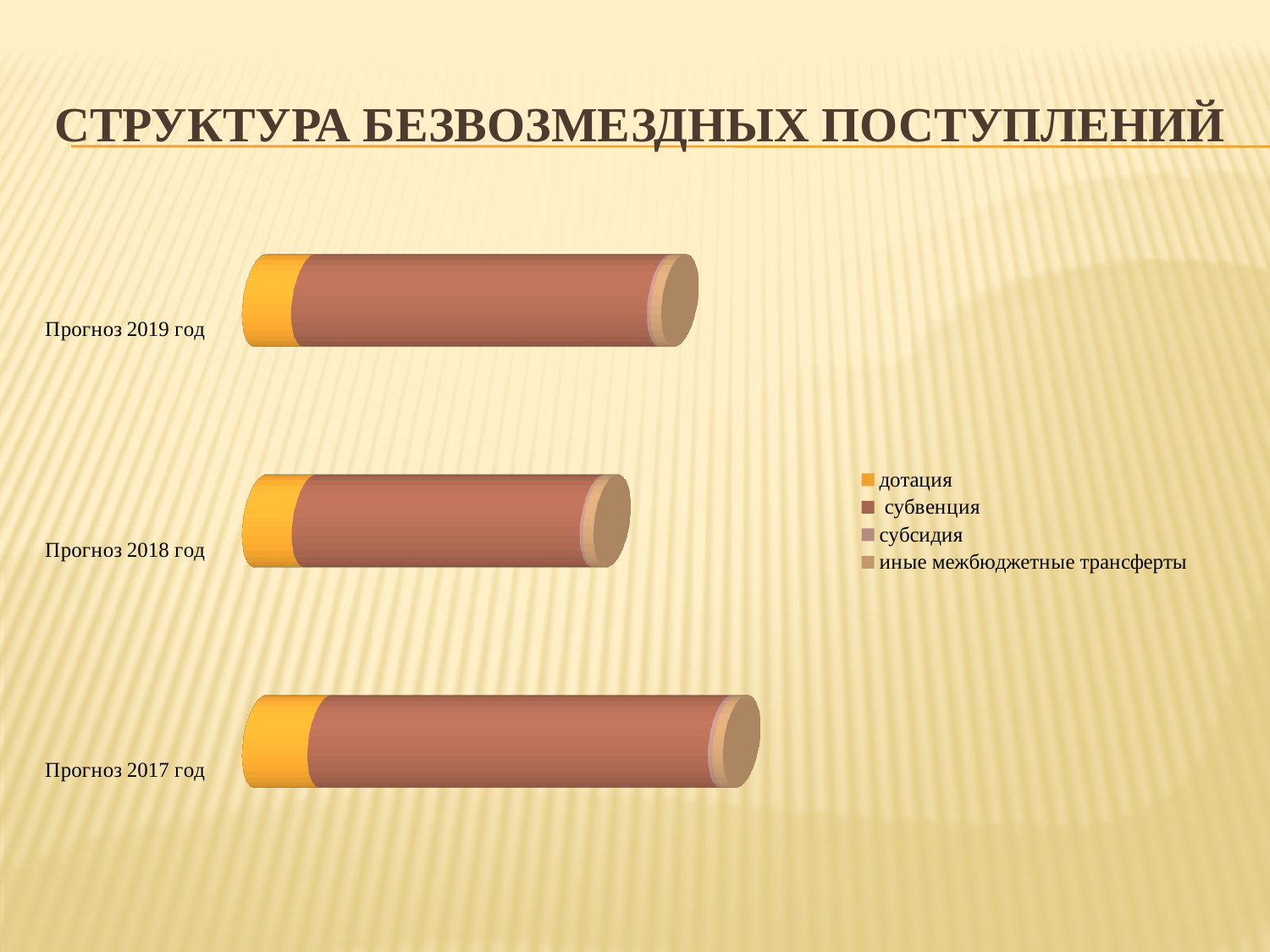
Which series is shown in yellow/orange in the legend? дотация Which category has the longest bar overall? Прогноз 2017 год How many series does the legend list? 4 Which series takes up the largest segment of the Прогноз 2019 год bar? субвенция Are the bars in the chart oriented horizontally or vertically? Horizontally What is the title of the slide chart? СТРУКТУРА БЕЗВОЗМЕЗДНЫХ ПОСТУПЛЕНИЙ How many categories (bars) does the chart show? 3 Which bar is longer overall, Прогноз 2019 год or Прогноз 2018 год? Прогноз 2019 год Which category has the shortest bar overall? Прогноз 2018 год Which bar is longer overall, Прогноз 2017 год or Прогноз 2019 год? Прогноз 2017 год What kind of chart is shown on the slide? Stacked bar chart